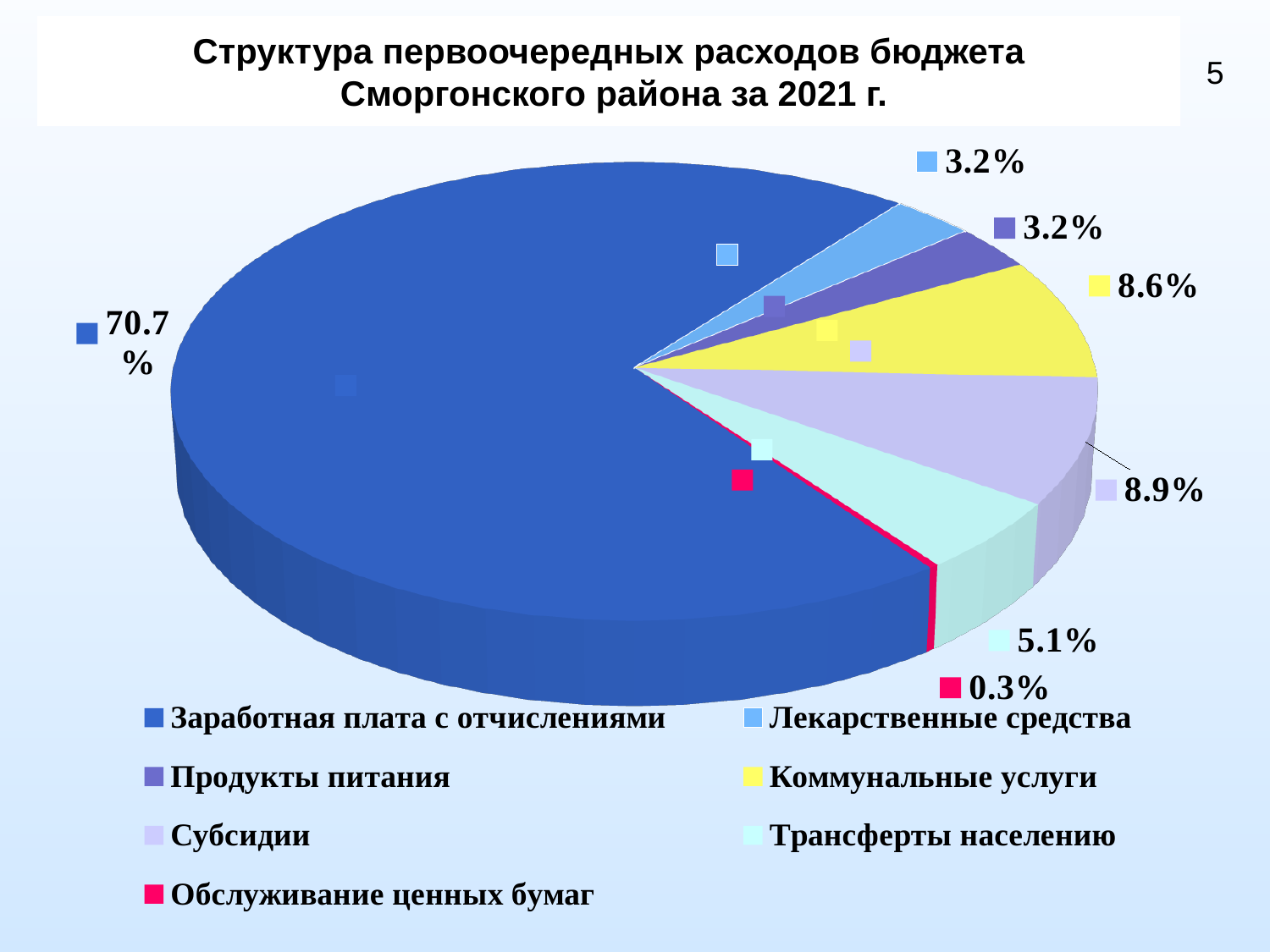
What share of the pie does Трансферты населению have? 5.1% Which category has the smallest share of the pie? Обслуживание ценных бумаг Which is larger, the share of Трансферты населению or the share of Лекарственные средства? Трансферты населению What share of the pie does Субсидии have? 8.9% What is the difference between the shares of Субсидии and Коммунальные услуги? 0.3% How many categories does the pie chart show? 7 What share of the pie does Коммунальные услуги have? 8.6% What is the title of the chart? Структура первоочередных расходов бюджета Сморгонского района за 2021 г. What kind of chart is shown on the slide? Pie chart What share of the pie does Обслуживание ценных бумаг have? 0.3% Which category has the largest share of the pie? Заработная плата с отчислениями What share of the pie does Заработная плата с отчислениями have? 70.7%